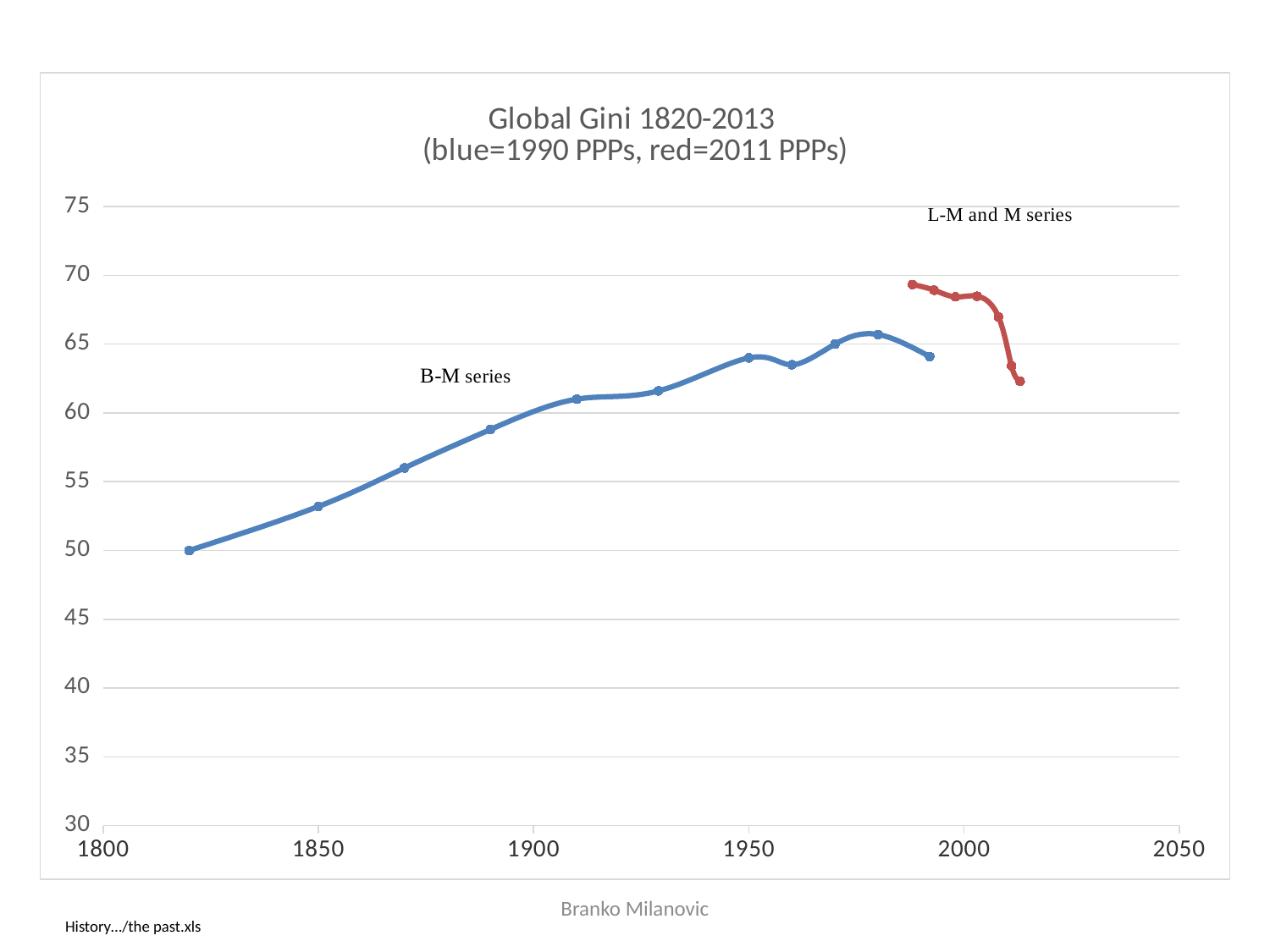
Is the value of the blue series at 1890 greater or less than 55? greater Does the red series rise or fall from its first point to its last point? fall Which is larger: the blue series value at 1820 or at 1950? 1950 Which series is labelled "B-M series" on the chart? the blue series Does the blue series rise or fall between 1820 and 1980? rise Is the value of the blue series at 1820 greater or less than 55? less What is the title of the chart? Global Gini 1820-2013 (blue=1990 PPPs, red=2011 PPPs) What kind of chart is shown on the slide? line chart Is the last point of the red series greater or less than 65? less Which series reaches the highest value on the chart, the blue or the red? the red series